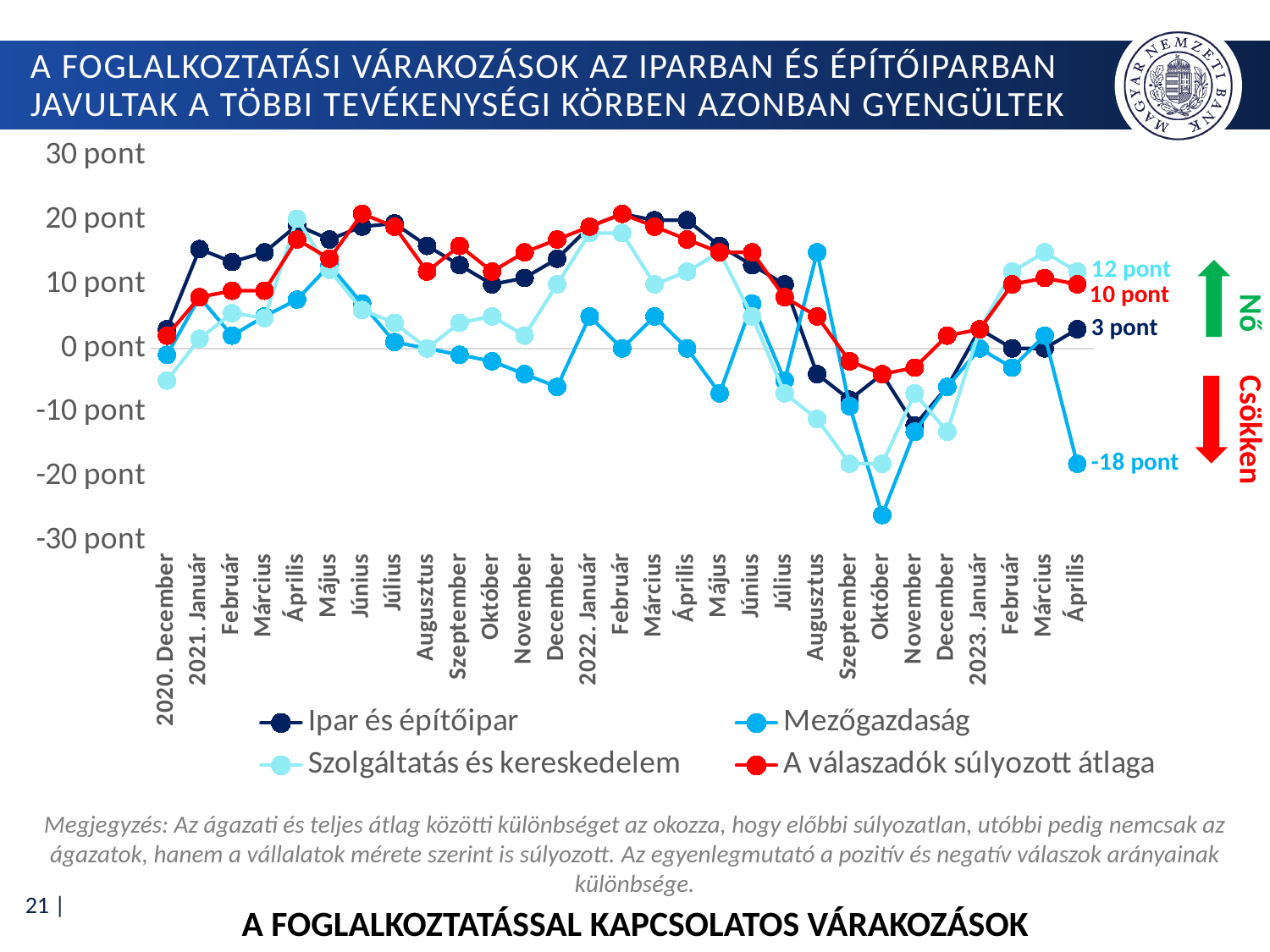
What is the difference between the Szolgáltatás és kereskedelem and Mezőgazdaság values in 2023 Április? 30 pont Is the value for Mezőgazdaság in 2022 Október greater or less than -20 pont? less What is the value for Ipar és építőipar in 2023 Április? 3 pont Which series has the lowest value in 2023 Április? Mezőgazdaság Which series has the highest value in 2023 Április? Szolgáltatás és kereskedelem What is the value for Szolgáltatás és kereskedelem in 2023 Április? 12 pont What is the value for A válaszadók súlyozott átlaga in 2023 Április? 10 pont What kind of chart is shown on the slide? line chart How many series does the legend list? 4 What is the value for Mezőgazdaság in 2023 Április? -18 pont In 2023 Április, which is larger: A válaszadók súlyozott átlaga or Ipar és építőipar? A válaszadók súlyozott átlaga Does the Mezőgazdaság series rise or fall from 2023 Március to 2023 Április? fall